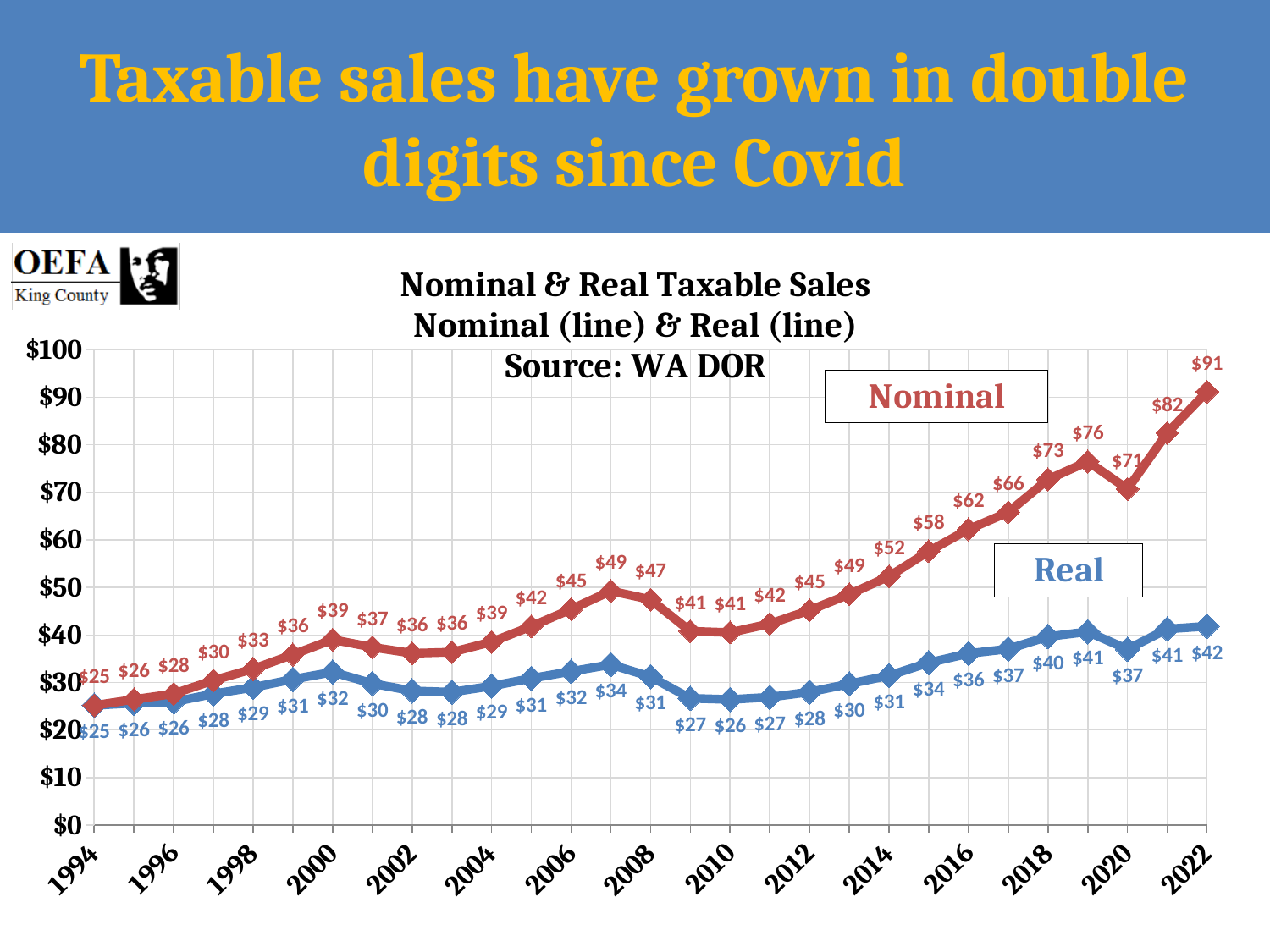
What is the Real taxable sales value for 2010? $26 What is the lowest value shown for the Nominal series? $25 What kind of chart is shown on the slide? Line chart What is the Nominal taxable sales value for 2022? $91 Which is larger, the Nominal value for 2008 or the Nominal value for 2010? 2008 What is the Real taxable sales value for 2022? $42 What is the Nominal taxable sales value for 2020? $71 In which year does the Nominal series reach its highest value? 2022 How many series are plotted on the chart? 2 Is the Nominal value for 2021 greater or less than $80? greater What is the difference between the Nominal values for 2022 and 2020? $20 Does the Nominal series rise or fall between 2020 and 2022? Rise